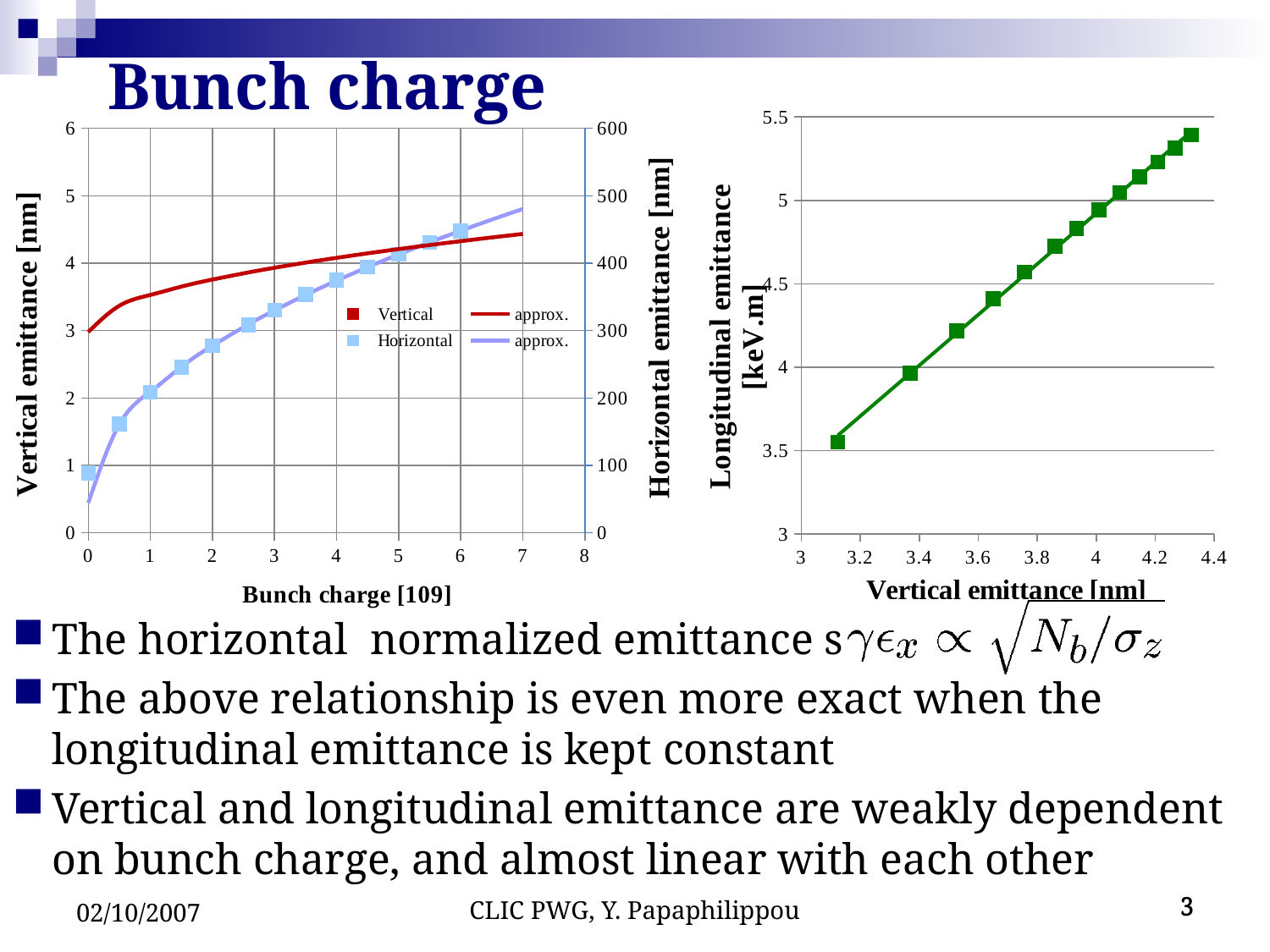
What kind of chart is the left chart (Vertical emittance vs Bunch charge)? line chart In the right chart, is the longitudinal emittance at a vertical emittance of about 3.4 nm greater or less than 4.5 keV.m? less What colour are the markers of the Horizontal series in the left chart? light blue How many entries does the legend of the left chart list? 4 What is the y-axis label of the right chart? Longitudinal emittance [keV.m] In the left chart, does the vertical emittance rise or fall as bunch charge increases? rises In the left chart, is the horizontal emittance at bunch charge 6 greater or less than 400 nm? greater In the right chart, is the longitudinal emittance at a vertical emittance of about 4.2 nm greater or less than 5 keV.m? greater In the left chart, does the horizontal emittance rise or fall as bunch charge increases? rises In the right chart, does the longitudinal emittance rise or fall as vertical emittance increases? rises